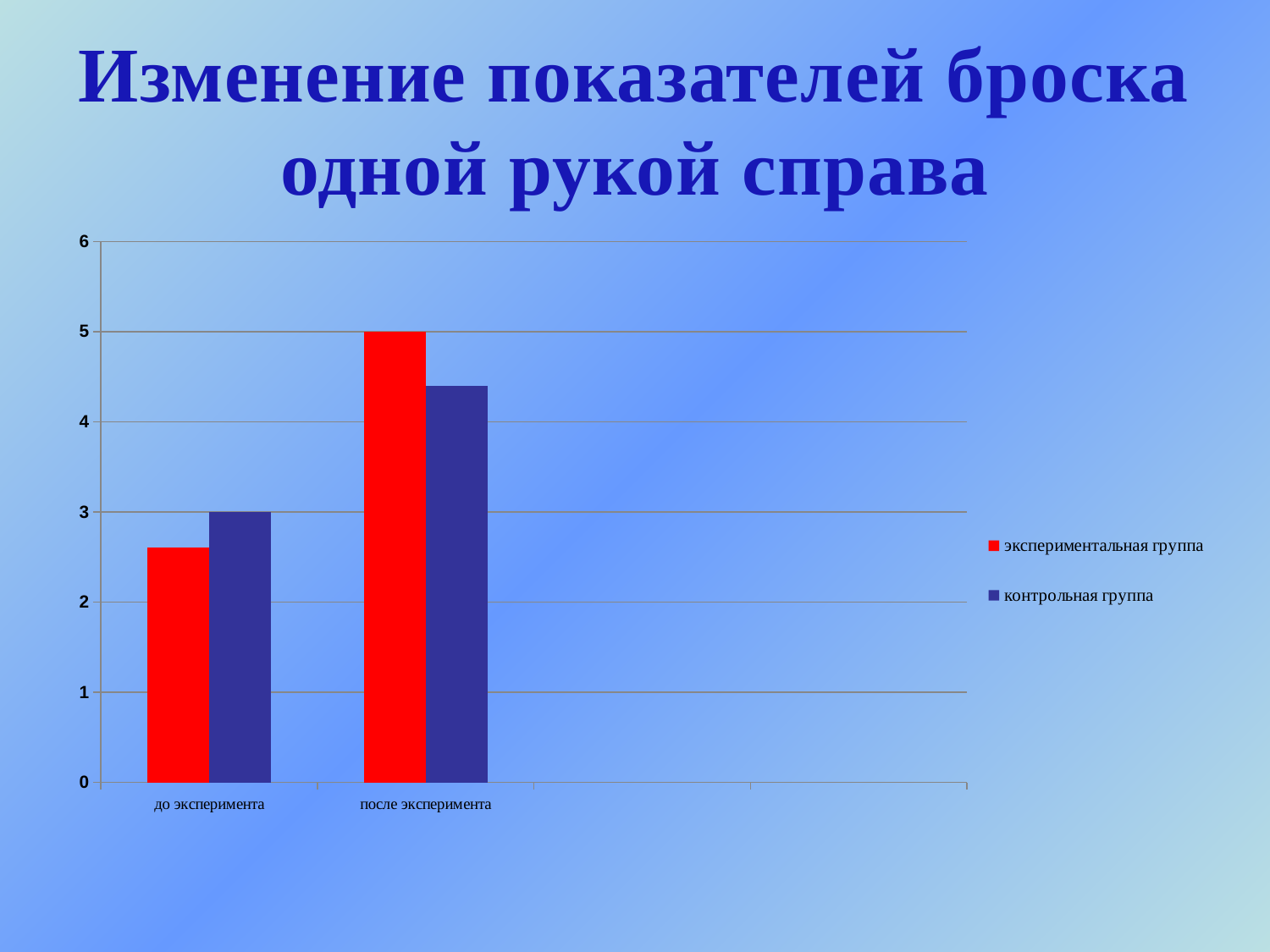
In the category до эксперимента, which group has the higher value? контрольная группа Is the value for экспериментальная группа in the category до эксперимента greater or less than 3? less Which colour represents экспериментальная группа in the legend? red How many series does the legend list? 2 Is the value for контрольная группа in the category после эксперимента greater or less than 4? greater In the category после эксперимента, which group has the higher value? экспериментальная группа Does the value for экспериментальная группа rise or fall from до эксперимента to после эксперимента? rise What is the value for экспериментальная группа in the category после эксперимента? 5 How many categories are shown on the x axis? 2 Which bar is the tallest in the chart? экспериментальная группа, после эксперимента What kind of chart is shown on the slide? bar chart What is the value for контрольная группа in the category до эксперимента? 3